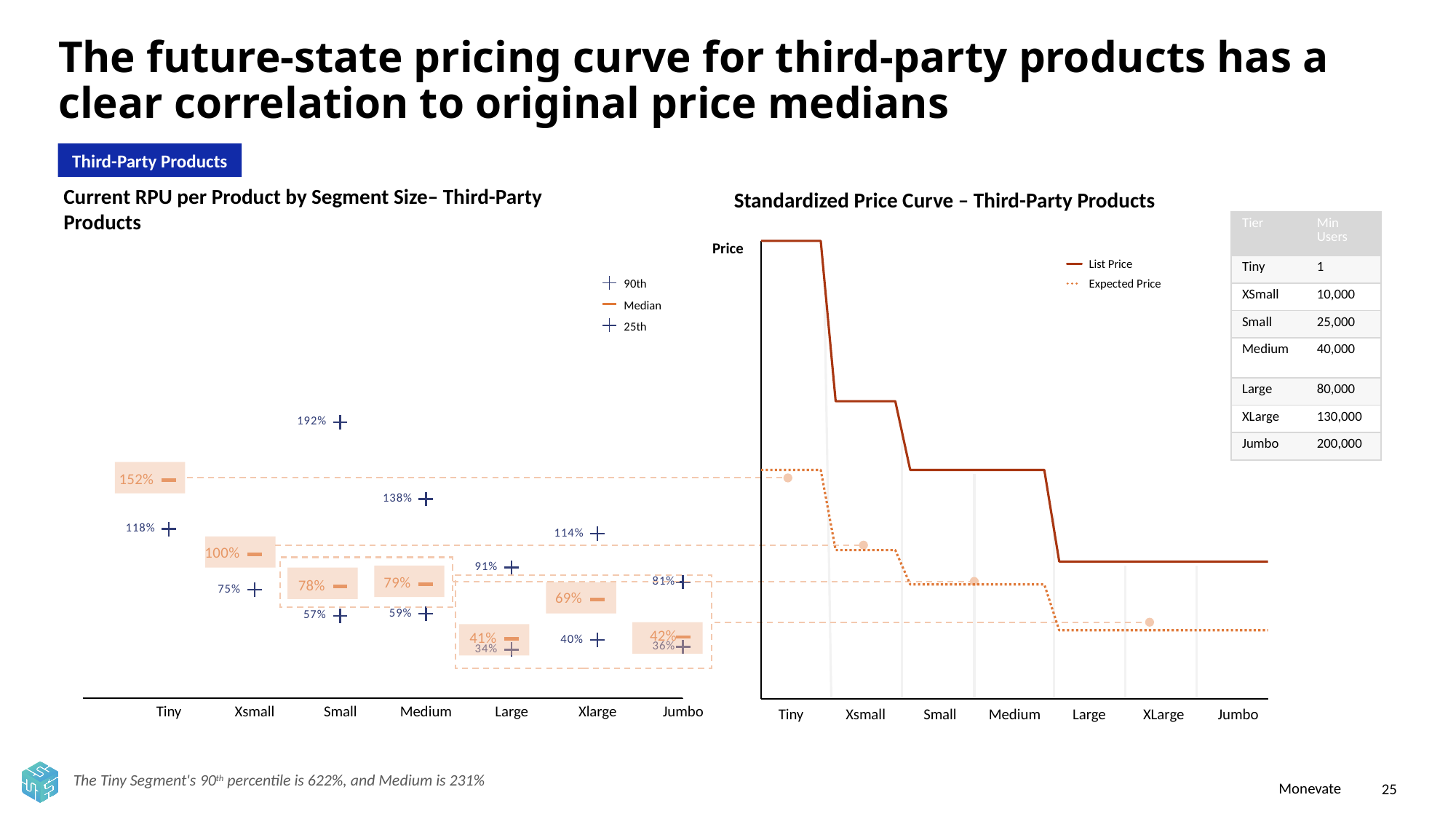
In the Current RPU per Product by Segment Size chart, which has the larger Median value, Small or Medium? Medium In the Current RPU per Product by Segment Size chart, what is the Median value for the Xlarge segment? 69% In the Current RPU per Product by Segment Size chart, what is the 90th percentile value for the Xlarge segment? 114% In the Current RPU per Product by Segment Size chart, what is the 25th percentile value for the Xsmall segment? 75% In the Current RPU per Product by Segment Size chart, what is the Median value for the Tiny segment? 152% In the Current RPU per Product by Segment Size chart, which segment has the highest Median value? Tiny How many segment categories are shown on the x axis of the Current RPU per Product by Segment Size chart? 7 How many series does the legend of the Current RPU per Product by Segment Size chart list? 3 In the Current RPU per Product by Segment Size chart, which segment has the lowest Median value? Large In the Standardized Price Curve – Third-Party Products chart, does the List Price rise or fall from Tiny to Jumbo? Fall In the Current RPU per Product by Segment Size chart, what is the difference between the Median values for Tiny and Xsmall? 52% What kind of chart is the Standardized Price Curve – Third-Party Products chart? Line chart